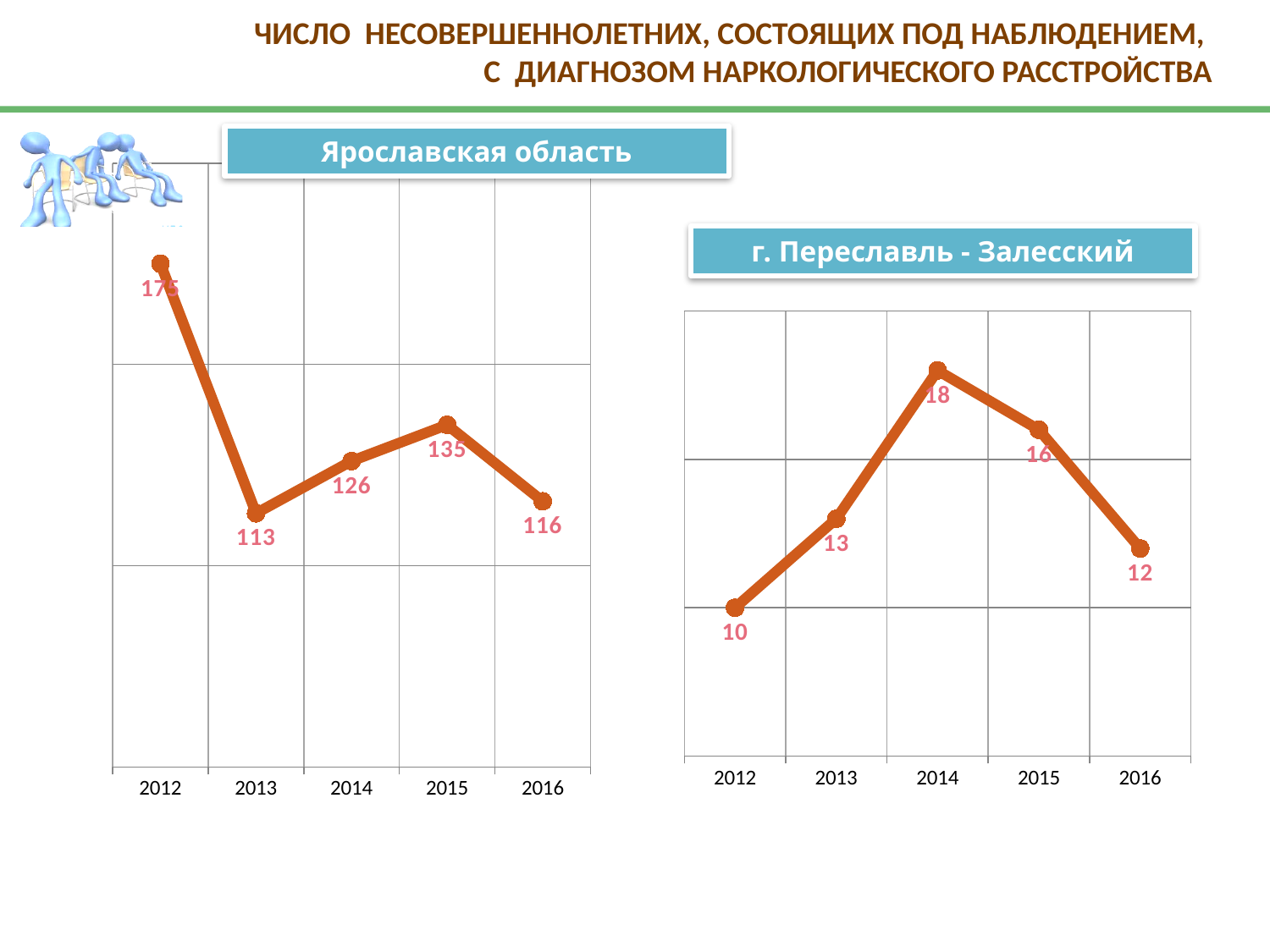
In the 'Ярославская область' chart, what is the value for 2012? 175 What kind of chart is the 'г. Переславль - Залесский' chart? line chart In the 'г. Переславль - Залесский' chart, what is the value for 2016? 12 In the 'Ярославская область' chart, which year has the lowest value? 2013 In the 'Ярославская область' chart, how many data points are plotted? 5 In the 'Ярославская область' chart, what is the value for 2013? 113 In the 'г. Переславль - Залесский' chart, which year has the lowest value? 2012 In the 'Ярославская область' chart, which year has the highest value? 2012 In the 'г. Переславль - Залесский' chart, which is larger, the value for 2013 or the value for 2015? 2015 In the 'г. Переславль - Залесский' chart, what is the difference between the values for 2014 and 2012? 8 In the 'г. Переславль - Залесский' chart, what is the value for 2014? 18 In the 'Ярославская область' chart, what is the difference between the values for 2015 and 2014? 9